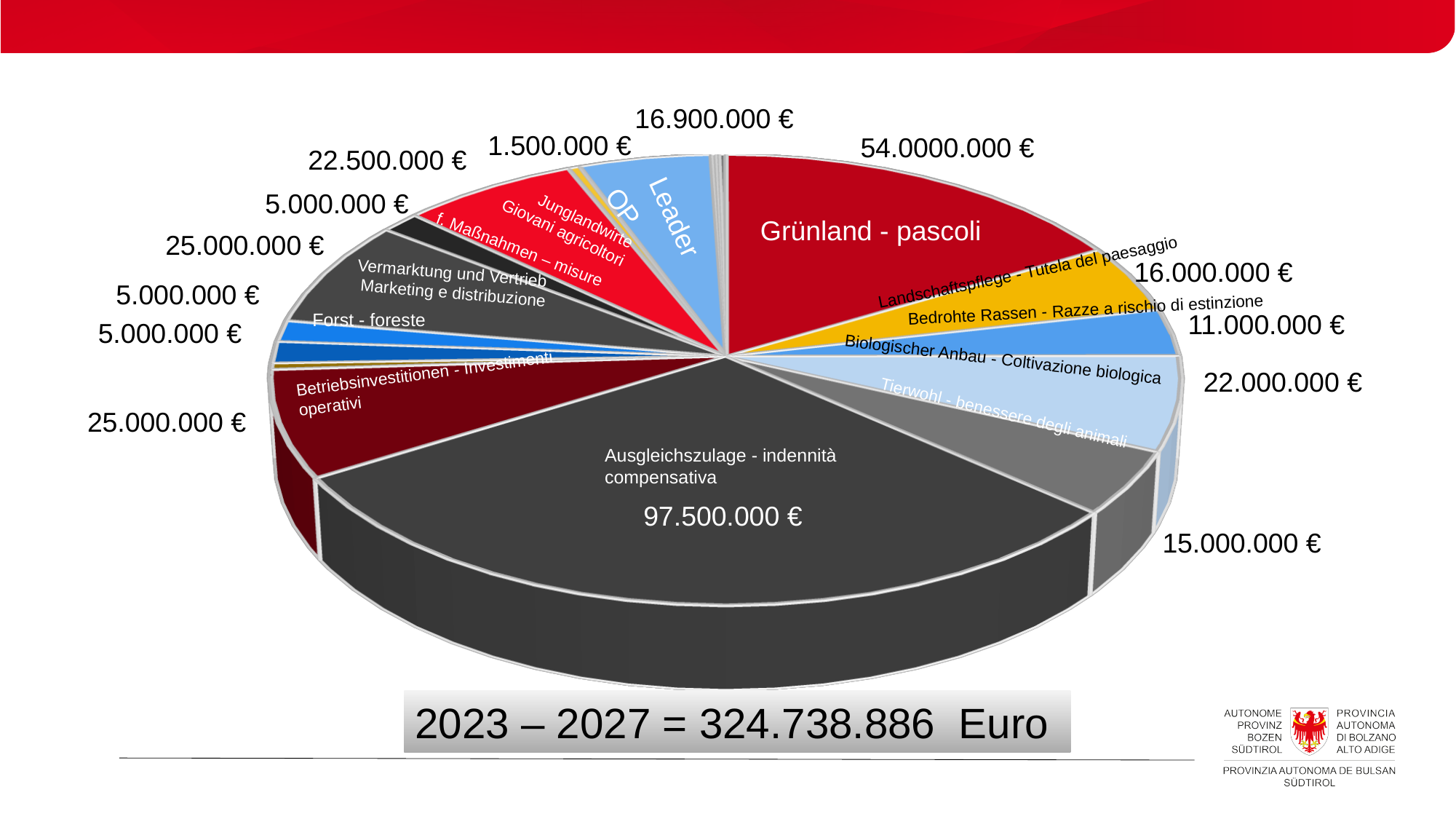
What is the value shown for Tierwohl - benessere degli animali? 15.000.000 € What is the value shown for Leader? 16.900.000 € What is the difference between Biologischer Anbau - Coltivazione biologica and Tierwohl - benessere degli animali? 7.000.000 € What kind of chart is shown on the slide? pie chart What is the value shown for Biologischer Anbau - Coltivazione biologica? 22.000.000 € What total amount for 2023 – 2027 is stated below the chart? 324.738.886 Euro What is the value shown for Grünland - pascoli? 54.0000.000 € Which category has the largest slice of the pie? Ausgleichszulage - indennità compensativa Which years does the chart cover according to the text below it? 2023 – 2027 What is the value shown for Ausgleichszulage - indennità compensativa? 97.500.000 € What is the value shown for Bedrohte Rassen - Razze a rischio di estinzione? 11.000.000 € Which is larger, Grünland - pascoli or Biologischer Anbau - Coltivazione biologica? Grünland - pascoli